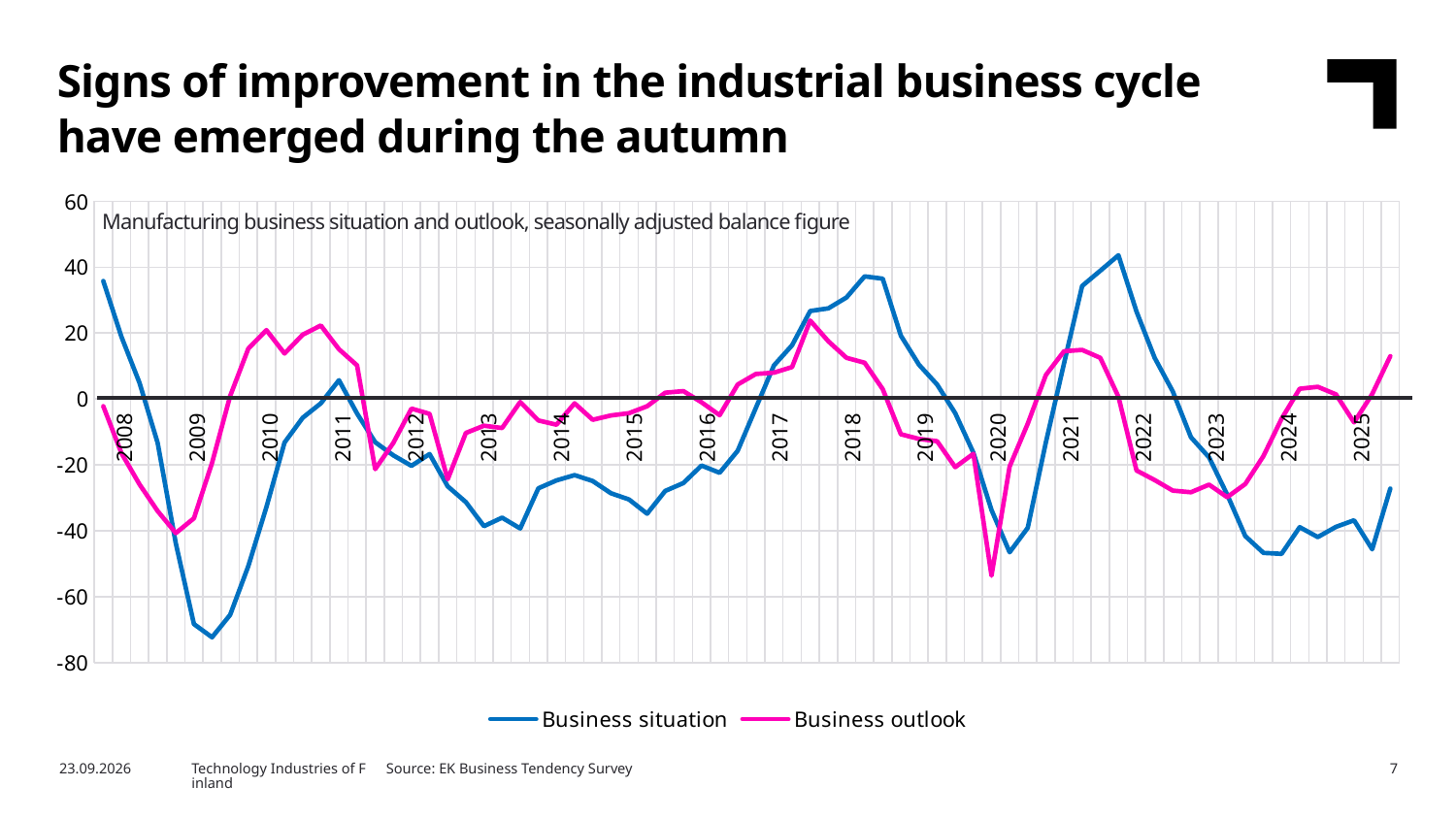
How many year labels are shown on the x axis? 18 What are the two series named in the legend? Business situation and Business outlook Is the lowest value of the Business outlook series (around 2020) greater or less than -40? less What is the title printed inside the chart area? Manufacturing business situation and outlook, seasonally adjusted balance figure What kind of chart is shown on the slide? line chart Is the peak of the Business situation series around 2018 greater or less than 20? greater Is the peak of the Business outlook series around 2011 greater or less than 0? greater Which series reaches the lowest value anywhere on the chart? Business situation How many series does the legend list? 2 Does the Business situation series rise or fall between 2022 and 2023? fall Which series reaches the highest value anywhere on the chart? Business situation